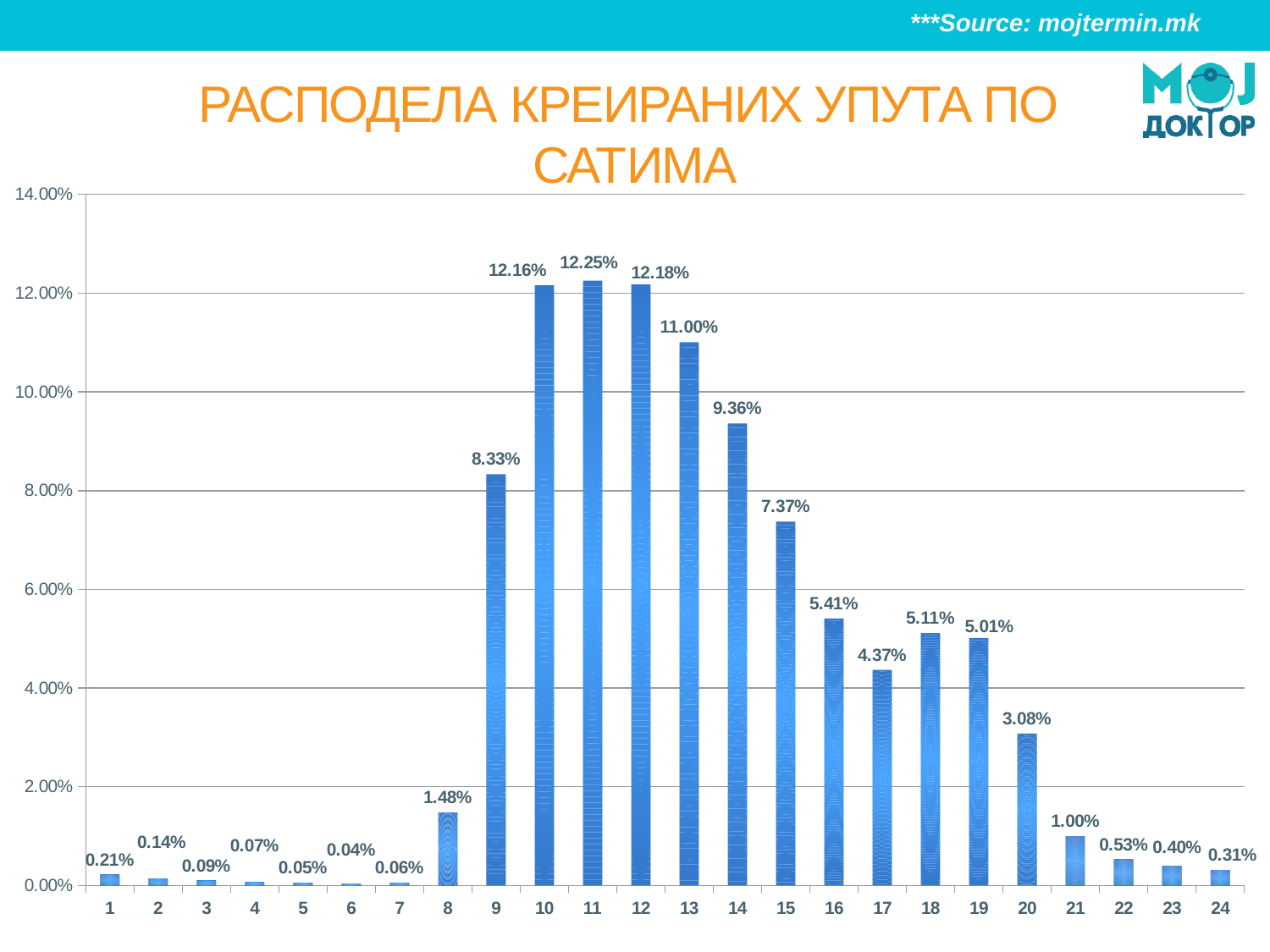
What is the value for hour 8? 1.48% What is the difference between the values for hour 13 and hour 14? 1.64% Is the value for hour 15 greater or less than 6.00%? greater Which hour has the highest value? 11 What is the difference between the values for hour 10 and hour 9? 3.83% Do the values rise or fall from hour 11 to hour 17? fall What kind of chart is shown on the slide? bar chart Which hour has the lowest value? 6 Which is larger, the value for hour 16 or hour 18? hour 16 How many hours (categories) are shown on the x axis? 24 What is the value for hour 13? 11.00% What is the value for hour 21? 1.00%